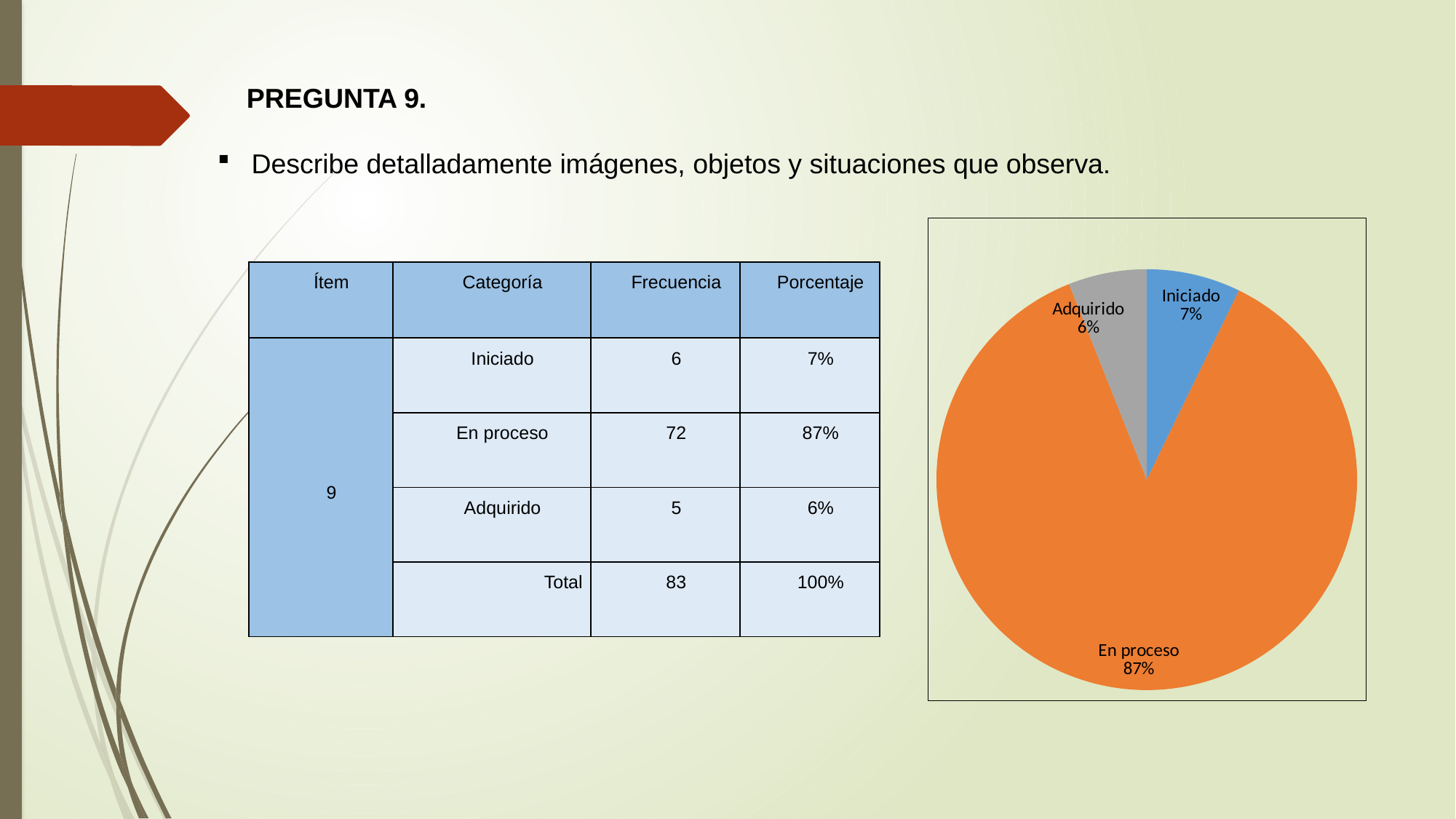
What is the difference in percentage points between Iniciado and Adquirido in the pie chart? 1 What is the difference in percentage points between En proceso and Iniciado in the pie chart? 80 What kind of chart is shown on the slide? pie chart What percentage does the pie chart show for Iniciado? 7% Which category has the smallest slice in the pie chart? Adquirido Which category has the largest slice in the pie chart? En proceso How many slices does the pie chart have? 3 What percentage does the pie chart show for Adquirido? 6% What colour is the Iniciado slice in the pie chart? blue What percentage does the pie chart show for En proceso? 87% Which slice is larger in the pie chart, En proceso or Adquirido? En proceso What colour is the En proceso slice in the pie chart? orange